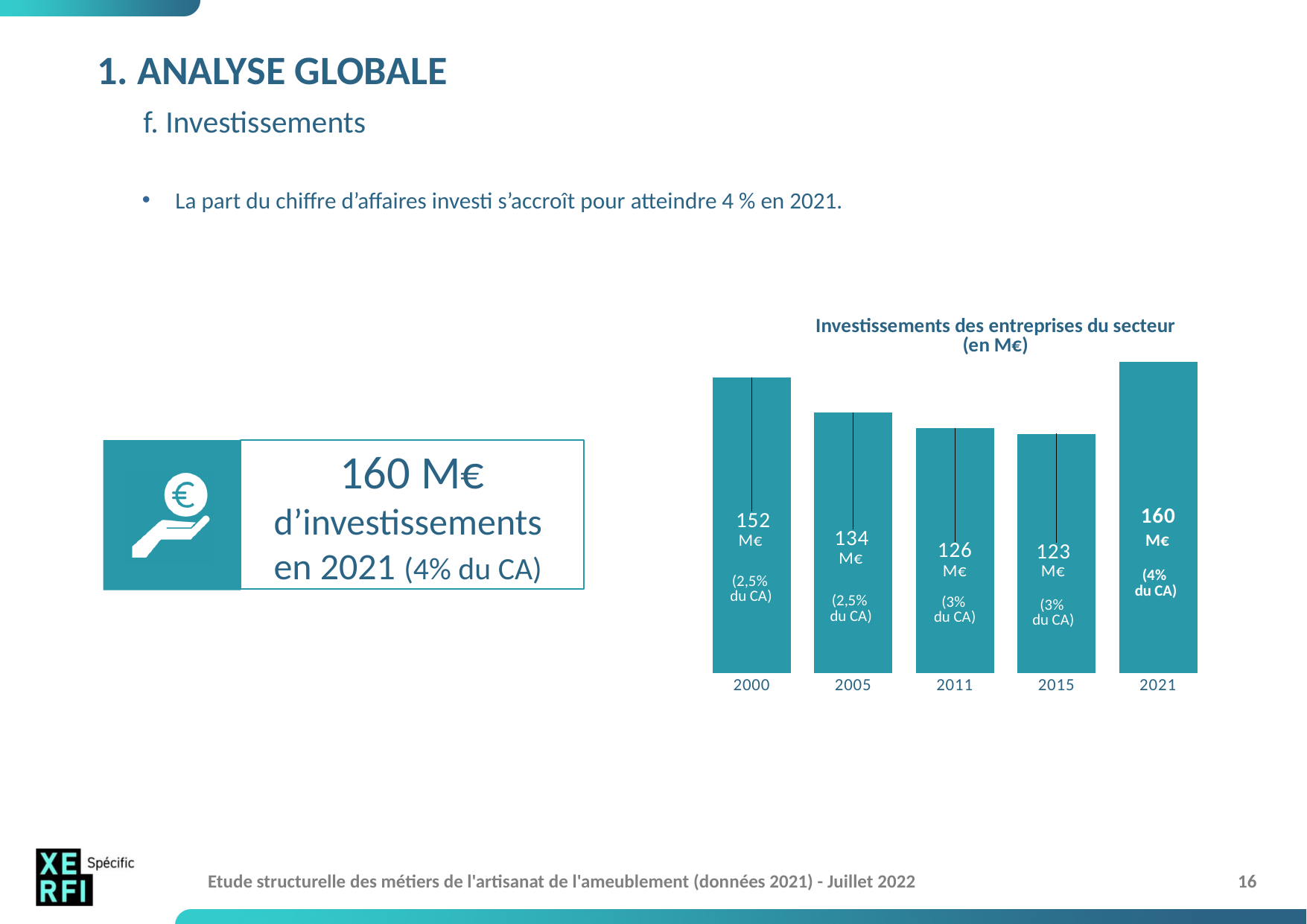
How many years are shown in the chart? 5 What is the investment value for 2015? 123 M€ What share of turnover (CA) did investments represent in 2011? 3% du CA Which is larger, the investment value for 2005 or for 2011? 2005 What kind of chart is shown? Bar chart What is the difference between the investment values for 2000 and 2005? 18 M€ What is the investment value for 2000? 152 M€ Which year has the lowest investment value? 2015 Which year has the highest investment value? 2021 What is the investment value for 2021? 160 M€ What is the difference between the investment values for 2021 and 2015? 37 M€ What is the title of the chart? Investissements des entreprises du secteur (en M€)